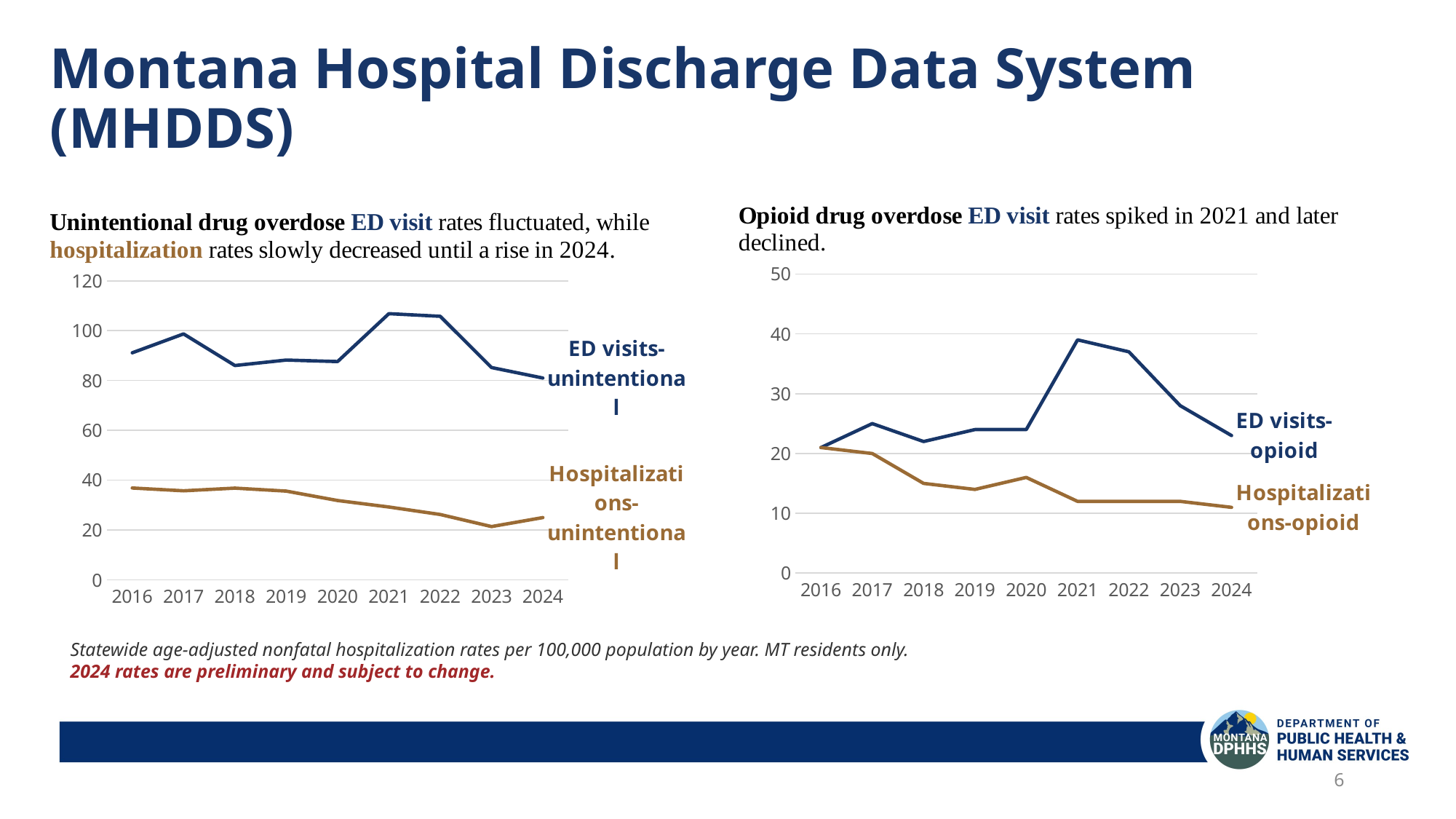
What colour is the line for Hospitalizations-opioid in the right chart? brown How many years are plotted on the x axis of the right chart (opioid drug overdose)? 9 In the left chart, which year has the lowest Hospitalizations-unintentional rate? 2023 In the left chart, is the Hospitalizations-unintentional value for 2016 greater or less than 40? less In the left chart, which series has the higher value in 2020, ED visits-unintentional or Hospitalizations-unintentional? ED visits-unintentional In the right chart, does the Hospitalizations-opioid rate rise or fall overall from 2016 to 2024? fall In the right chart, which year has the highest ED visits-opioid rate? 2021 In the left chart, is the ED visits-unintentional value for 2021 greater or less than 100? greater How many series does the left chart (unintentional drug overdose) show? 2 In the right chart, which year has the highest Hospitalizations-opioid rate? 2016 What type of chart is the left chart on unintentional drug overdose rates? line chart In the right chart, is the ED visits-opioid value for 2021 greater or less than 30? greater